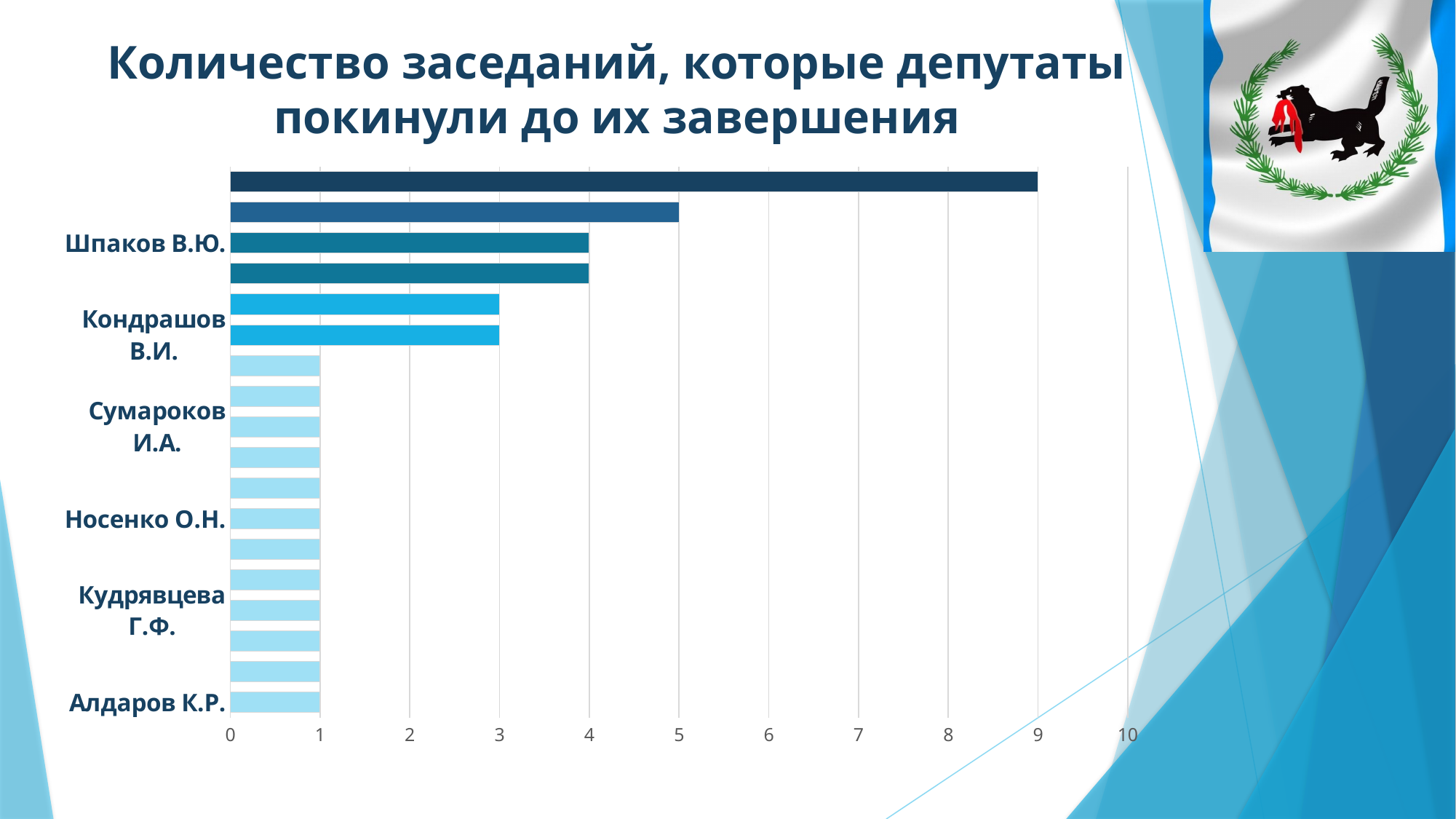
What is the difference between the values for Шпаков В.Ю. and Кондрашов В.И.? 1 What is the value for Алдаров К.Р.? 1 Is the value of the longest bar greater or less than 8? greater Which is larger, the value for Шпаков В.Ю. or the value for Кудрявцева Г.Ф.? Шпаков В.Ю. What is the value for Кондрашов В.И.? 3 What is the value for Сумароков И.А.? 1 How many meetings did Шпаков В.Ю. leave before their end, according to the chart? 4 What type of chart is shown on the slide? bar chart What is the highest value shown by any bar in the chart? 9 What is the title of the chart? Количество заседаний, которые депутаты покинули до их завершения What is the value for Носенко О.Н.? 1 What is the lowest value shown by any bar in the chart? 1